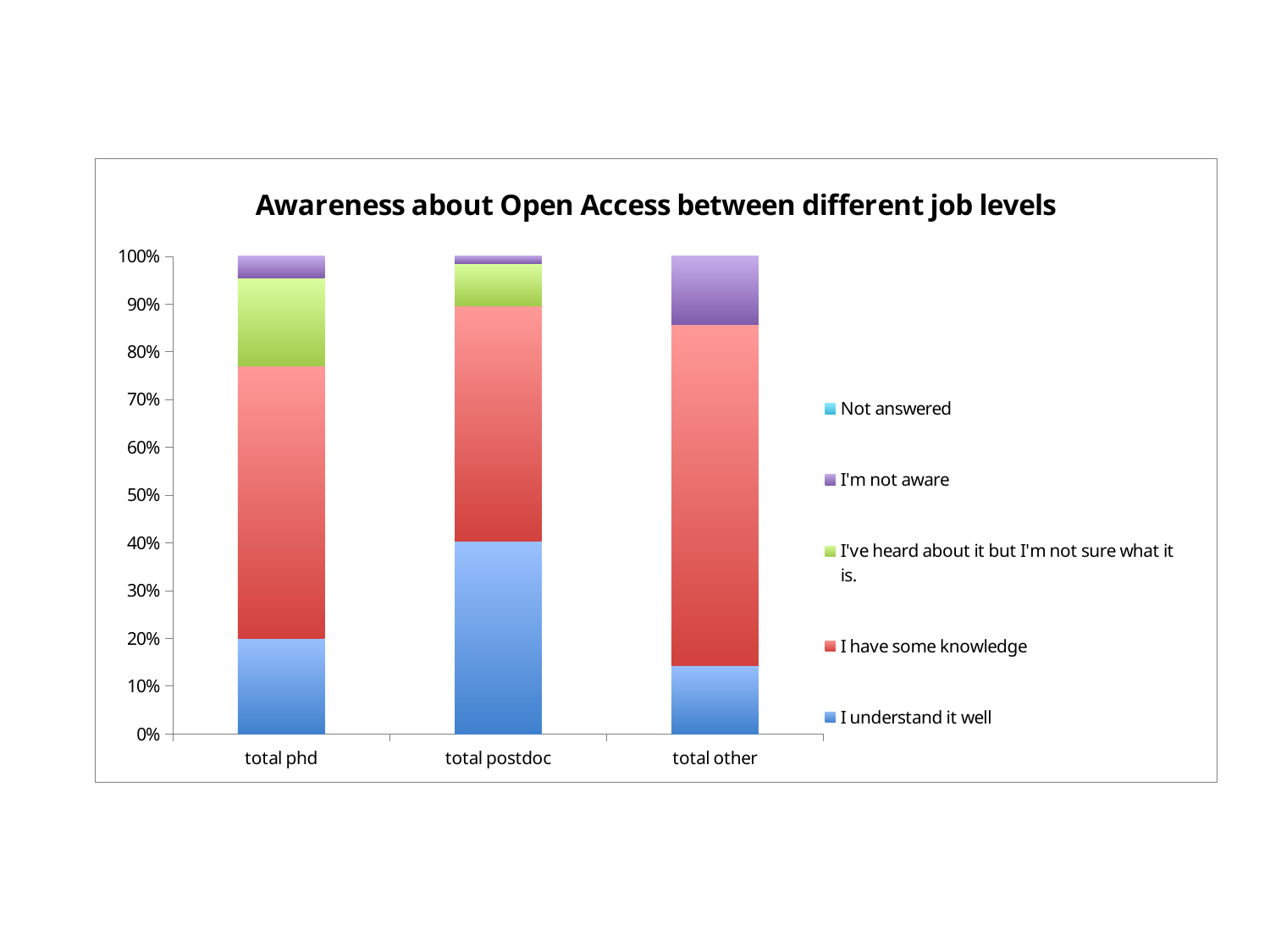
What kind of chart is shown on the slide? stacked bar chart What is the title of the chart? Awareness about Open Access between different job levels Which has the larger 'I'm not aware' share, total phd or total other? total other Which category has the largest 'I've heard about it but I'm not sure what it is.' share? total phd Which category has the smallest 'I understand it well' share? total other Is the 'I understand it well' share for total postdoc greater or less than 30%? greater Which category has the largest 'I understand it well' share? total postdoc Is the 'I'm not aware' share for total other greater or less than 10%? greater Is the 'I understand it well' share for total phd greater or less than 30%? less How many categories are shown on the x axis? 3 How many series does the legend list? 5